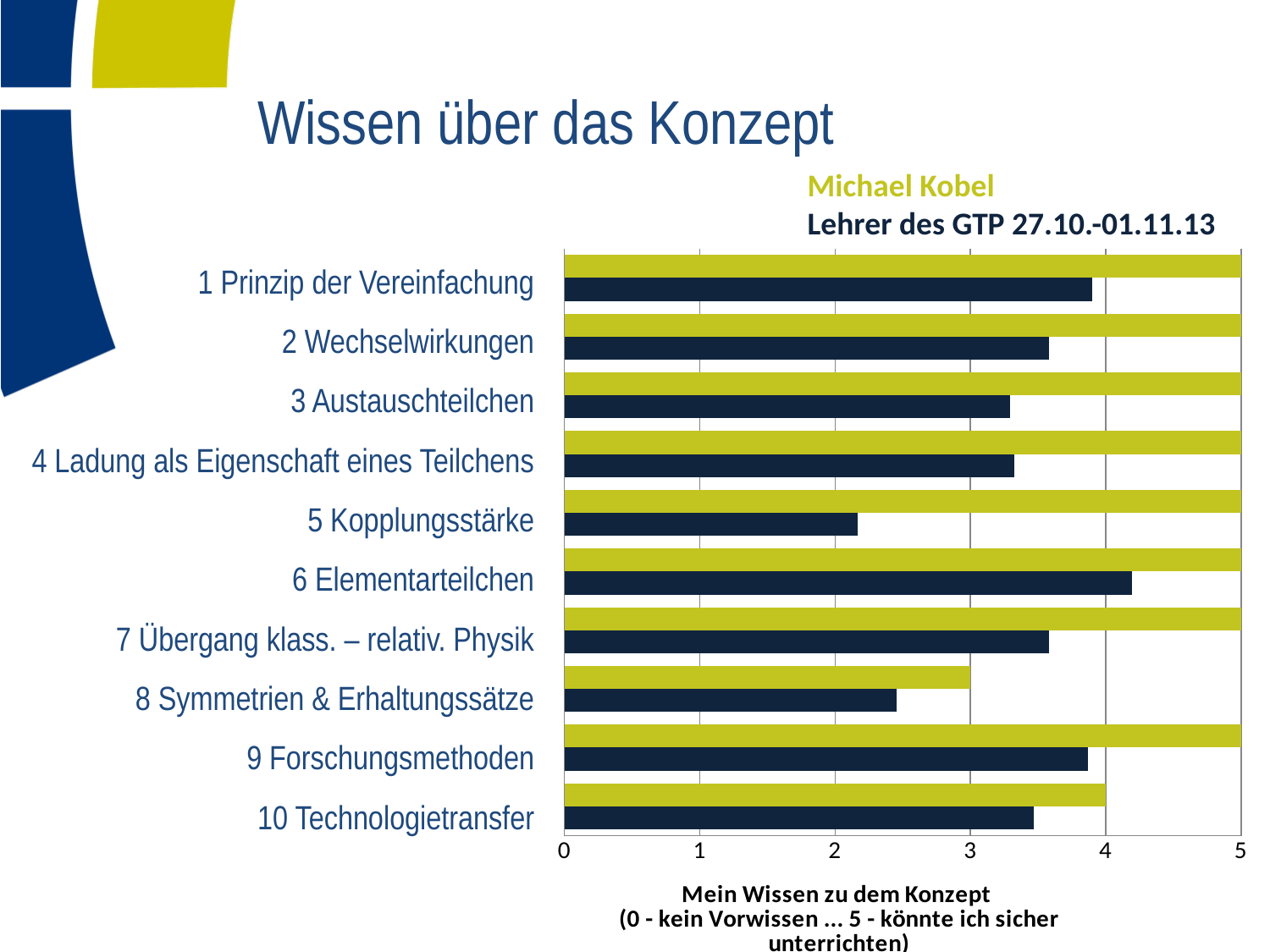
Which category has the highest value for Lehrer des GTP 27.10.-01.11.13? 6 Elementarteilchen Which category has the lowest Michael Kobel value? 8 Symmetrien & Erhaltungssätze Is the Lehrer des GTP 27.10.-01.11.13 value for 5 Kopplungsstärke greater or less than 3? less How many series does the legend list? 2 Which category has the lowest value for Lehrer des GTP 27.10.-01.11.13? 5 Kopplungsstärke What is the Michael Kobel value for 8 Symmetrien & Erhaltungssätze? 3 Is the Lehrer des GTP 27.10.-01.11.13 value for 6 Elementarteilchen greater or less than 4? greater What is the difference between the Michael Kobel values for 1 Prinzip der Vereinfachung and 8 Symmetrien & Erhaltungssätze? 2 How many concept categories are plotted on the chart? 10 What kind of chart is shown on the slide? bar chart What is the Michael Kobel value for 1 Prinzip der Vereinfachung? 5 What is the Michael Kobel value for 10 Technologietransfer? 4